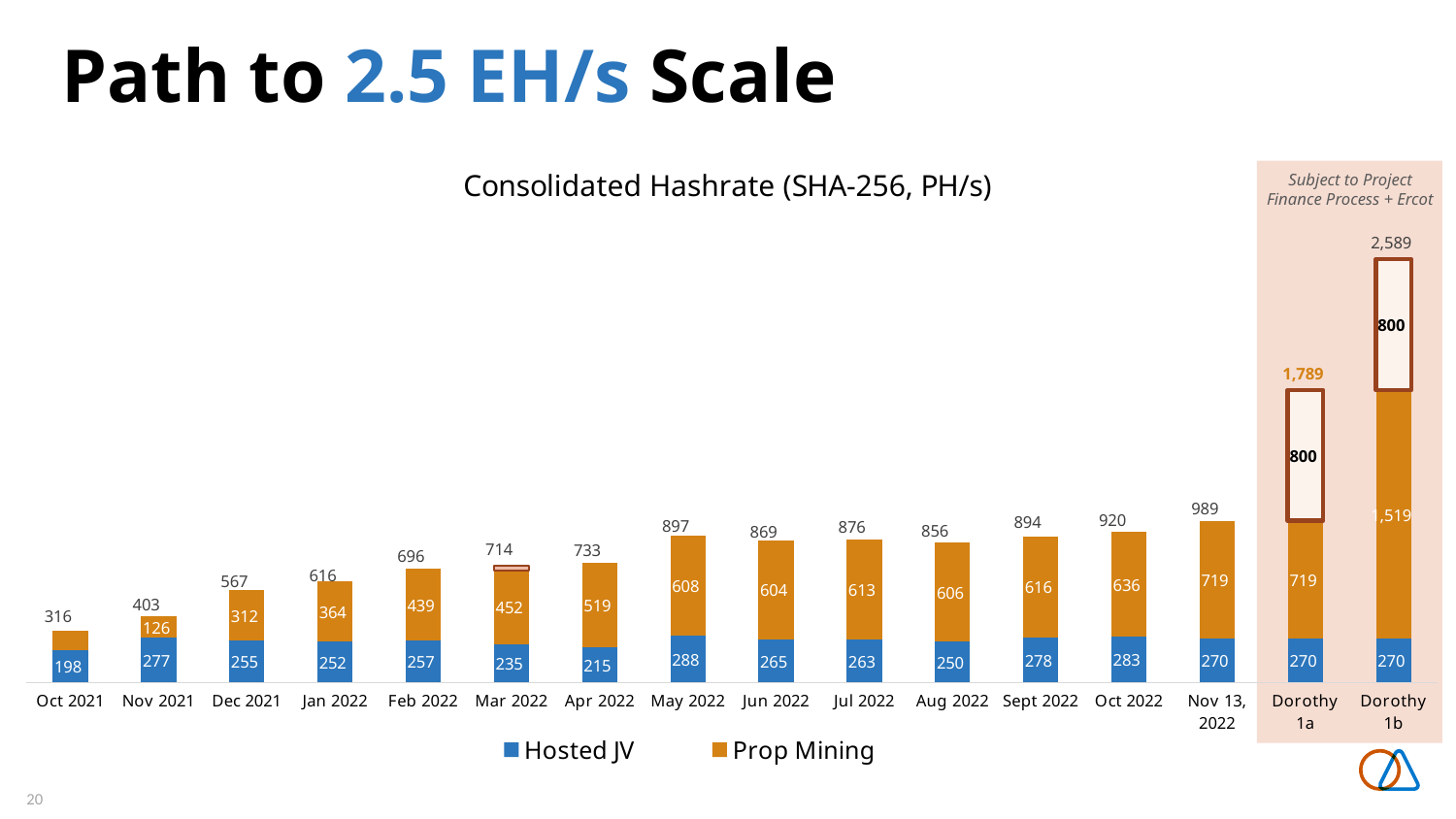
What is the Hosted JV value for May 2022? 288 What is the difference between the Hosted JV values for May 2022 and Apr 2022? 73 Which category has the highest total hashrate? Dorothy 1b Which category has the lowest total hashrate? Oct 2021 What kind of chart is shown on the slide? Stacked bar chart How many series does the legend list? 2 How many categories are shown on the x axis? 16 What is the total consolidated hashrate shown for Nov 13, 2022? 989 What is the total value labeled for Dorothy 1a? 1,789 What is the title of the chart? Consolidated Hashrate (SHA-256, PH/s) Which is larger, the Prop Mining value for Jul 2022 or for Jun 2022? Jul 2022 What is the Prop Mining value for Oct 2022? 636